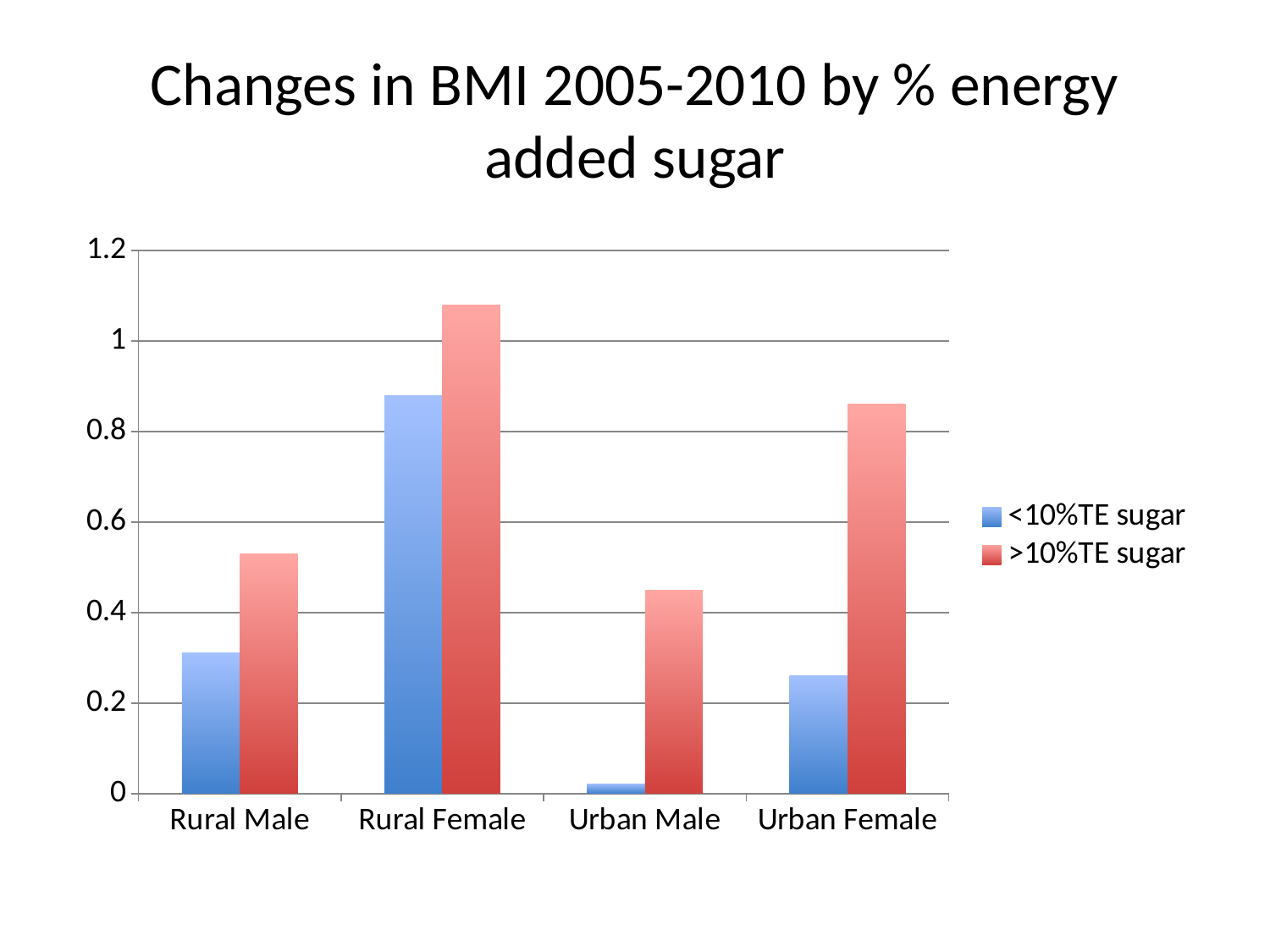
Is the >10%TE sugar value for Rural Female greater or less than 1? greater What kind of chart is shown on the slide? bar chart Is the <10%TE sugar value for Rural Male greater or less than 0.2? greater How many series does the legend list? 2 Which category has the lowest value for the <10%TE sugar series? Urban Male What is the title of the chart? Changes in BMI 2005-2010 by % energy added sugar How many categories are shown on the x axis? 4 Is the <10%TE sugar value for Urban Male greater or less than 0.2? less Which category has the lowest value for the >10%TE sugar series? Urban Male Which category has the highest value for the >10%TE sugar series? Rural Female Which is larger: the >10%TE sugar value for Rural Female or for Urban Female? Rural Female